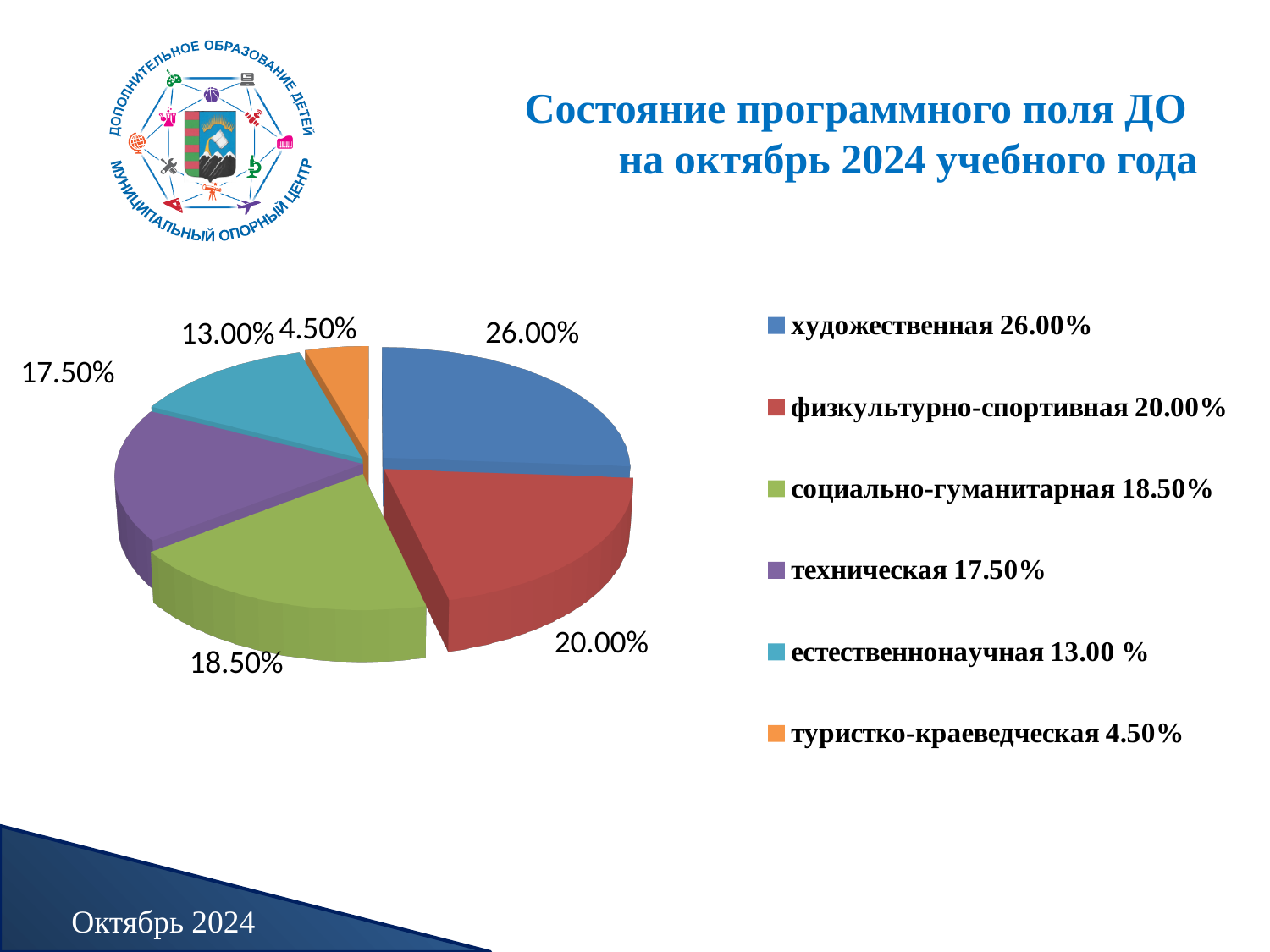
Which category has the smallest slice of the pie? туристко-краеведческая What is the value shown for физкультурно-спортивная? 20.00% What share of the pie does the художественная slice have? 26.00% What is the value shown for туристко-краеведческая? 4.50% Which category has the largest slice of the pie? художественная How many categories are shown in the pie chart? 6 What colour is the slice for социально-гуманитарная? green What kind of chart is shown on the slide? pie chart What is the value shown for социально-гуманитарная? 18.50% What is the value shown for техническая? 17.50% Which is larger, the share for техническая or the share for естественнонаучная? техническая What is the difference between the художественная and физкультурно-спортивная shares? 6.00%